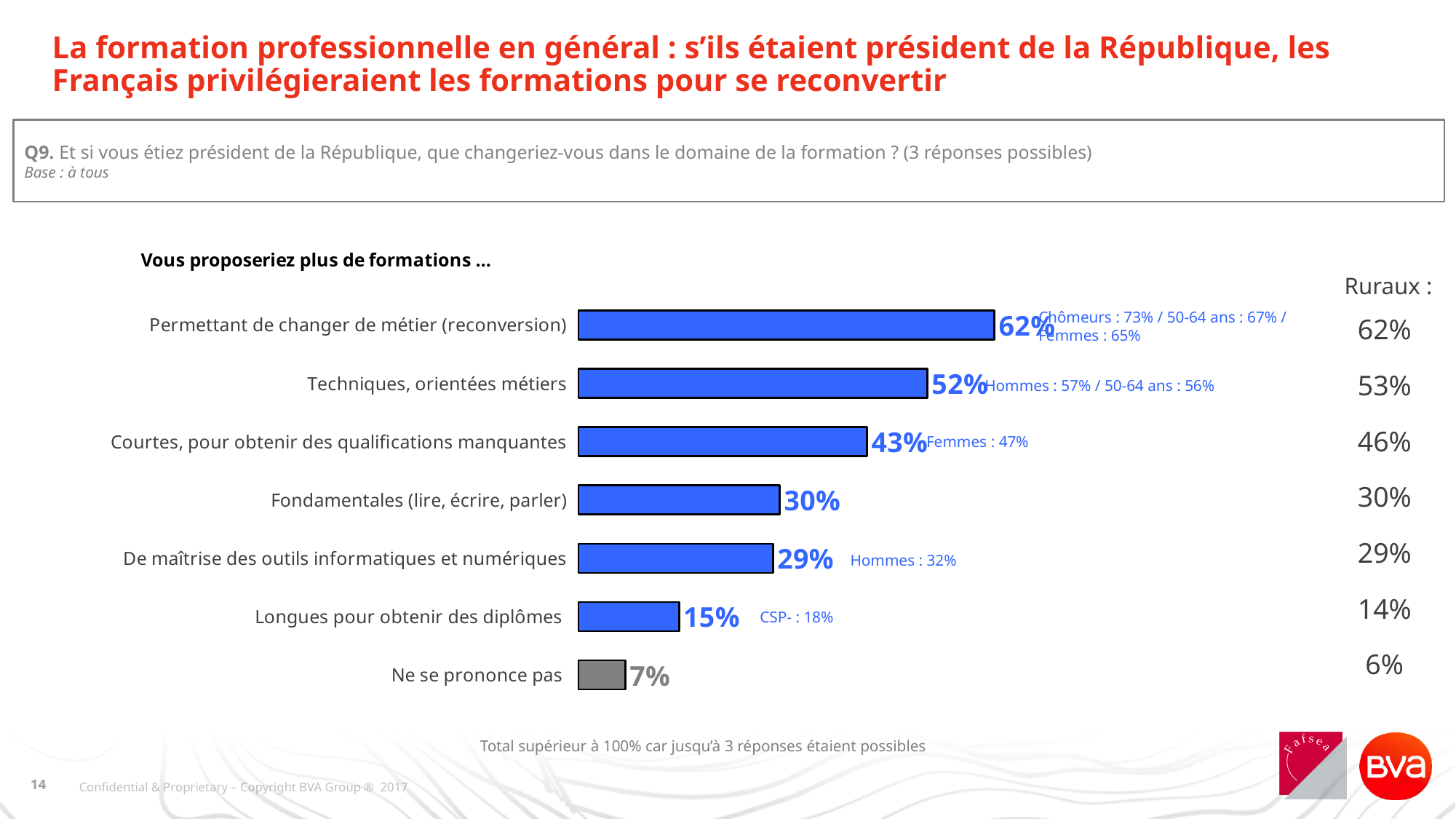
Which category has the lowest value in the chart? Ne se prononce pas Which bar in the chart is coloured grey rather than blue? Ne se prononce pas Which is larger: the value for "Fondamentales (lire, écrire, parler)" or for "De maîtrise des outils informatiques et numériques"? Fondamentales (lire, écrire, parler) Which category has the highest value in the chart? Permettant de changer de métier (reconversion) What is the value shown for "Longues pour obtenir des diplômes"? 15% What percentage of respondents chose "Permettant de changer de métier (reconversion)"? 62% What is the "Ruraux" value listed for "Techniques, orientées métiers"? 53% What kind of chart is shown on the slide? Bar chart What is the difference between the values for "Techniques, orientées métiers" and "Fondamentales (lire, écrire, parler)"? 22% What is the "Ruraux" value listed for "Ne se prononce pas"? 6% What is the value shown for "Courtes, pour obtenir des qualifications manquantes"? 43% How many categories are shown in the chart? 7